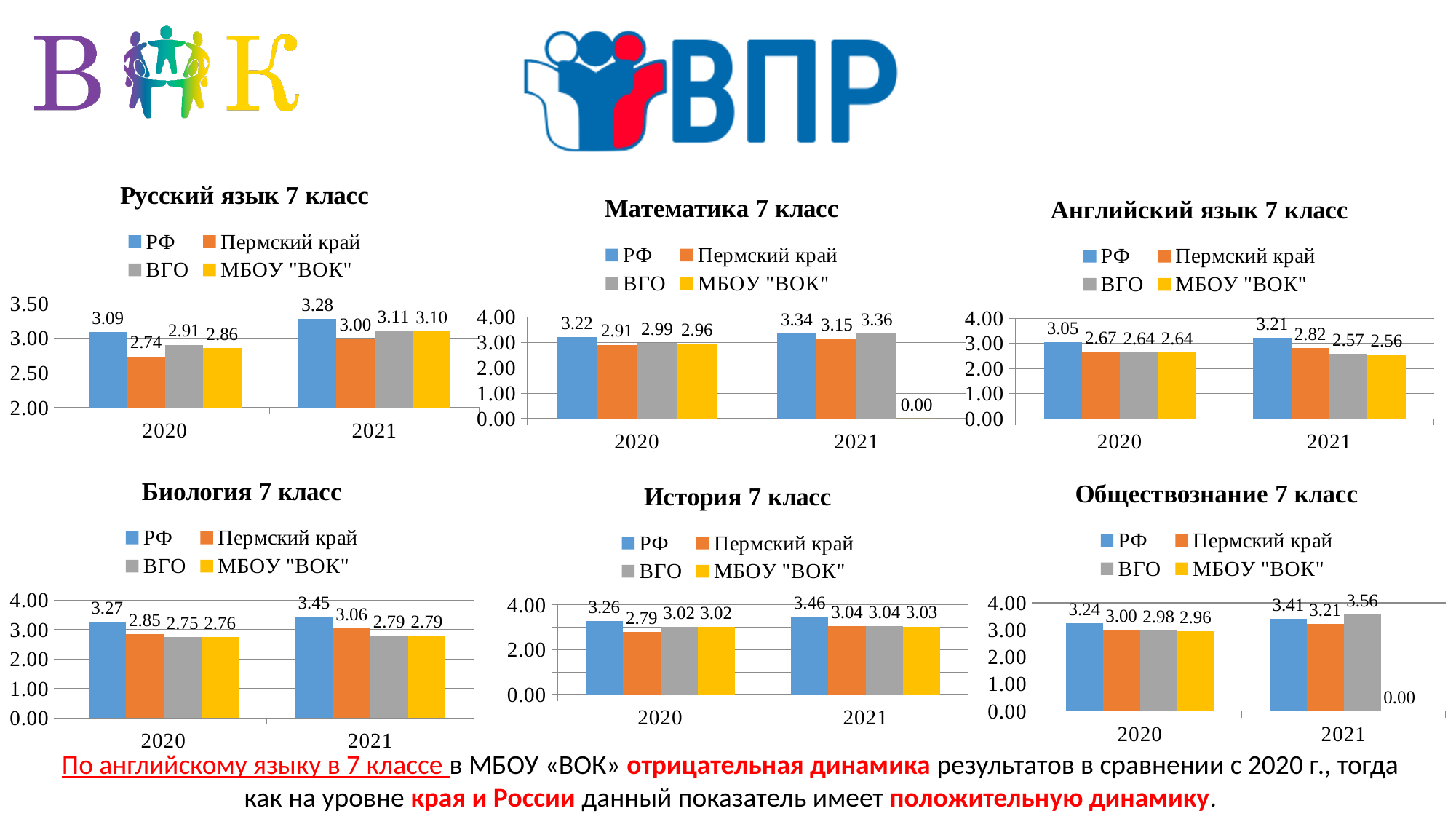
In the chart titled "История 7 класс", which series has the lowest value in 2020? Пермский край In the chart titled "Обществознание 7 класс", what is the value for МБОУ "ВОК" in 2021? 0.00 In the chart titled "Биология 7 класс", does the value for РФ rise or fall from 2020 to 2021? Rise How many series does the legend of the chart titled "Математика 7 класс" list? 4 What kind of chart is the chart titled "История 7 класс"? Bar chart In the chart titled "Английский язык 7 класс", what is the value for Пермский край in 2021? 2.82 In the chart titled "Русский язык 7 класс", what is the value for РФ in 2021? 3.28 In the chart titled "Обществознание 7 класс", which is larger in 2021: the value for РФ or the value for ВГО? ВГО In the chart titled "Математика 7 класс", what is the value for МБОУ "ВОК" in 2020? 2.96 In the chart titled "Биология 7 класс", which series has the highest value in 2021? РФ In the chart titled "Английский язык 7 класс", what is the difference between the МБОУ "ВОК" values for 2020 and 2021? 0.08 How many charts are shown on the slide? 6